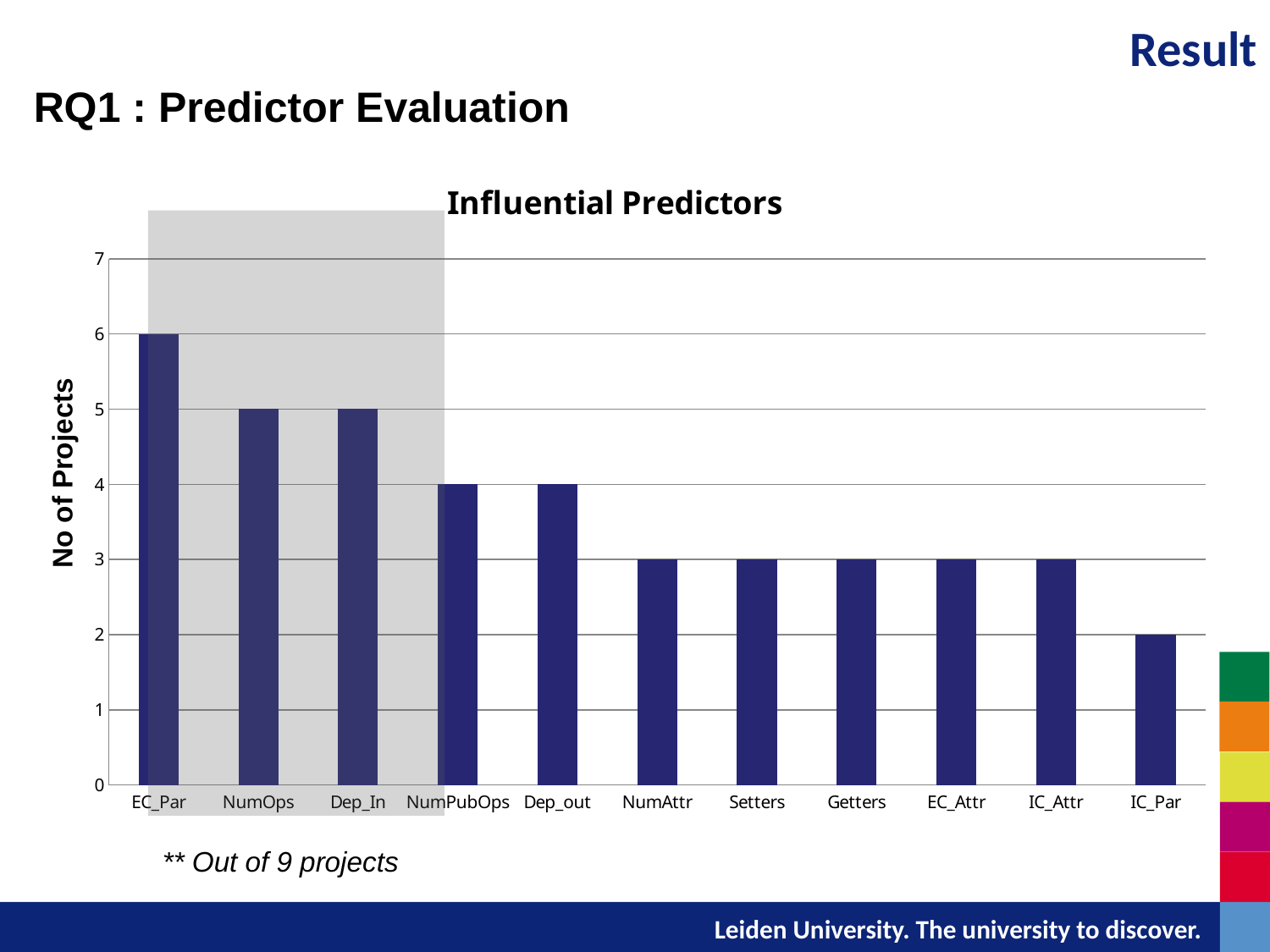
Which predictor has the highest number of projects? EC_Par How many predictors (categories) are shown on the x axis? 11 Which predictor has the lowest number of projects? IC_Par What is the value for EC_Par? 6 Which is larger, the value for Dep_In or the value for NumPubOps? Dep_In What is the value for Dep_out? 4 What is the label of the vertical axis? No of Projects What is the title of the chart? Influential Predictors What kind of chart is shown on the slide? bar chart What is the value for NumOps? 5 What is the value for IC_Par? 2 What is the difference between the values for EC_Par and IC_Par? 4